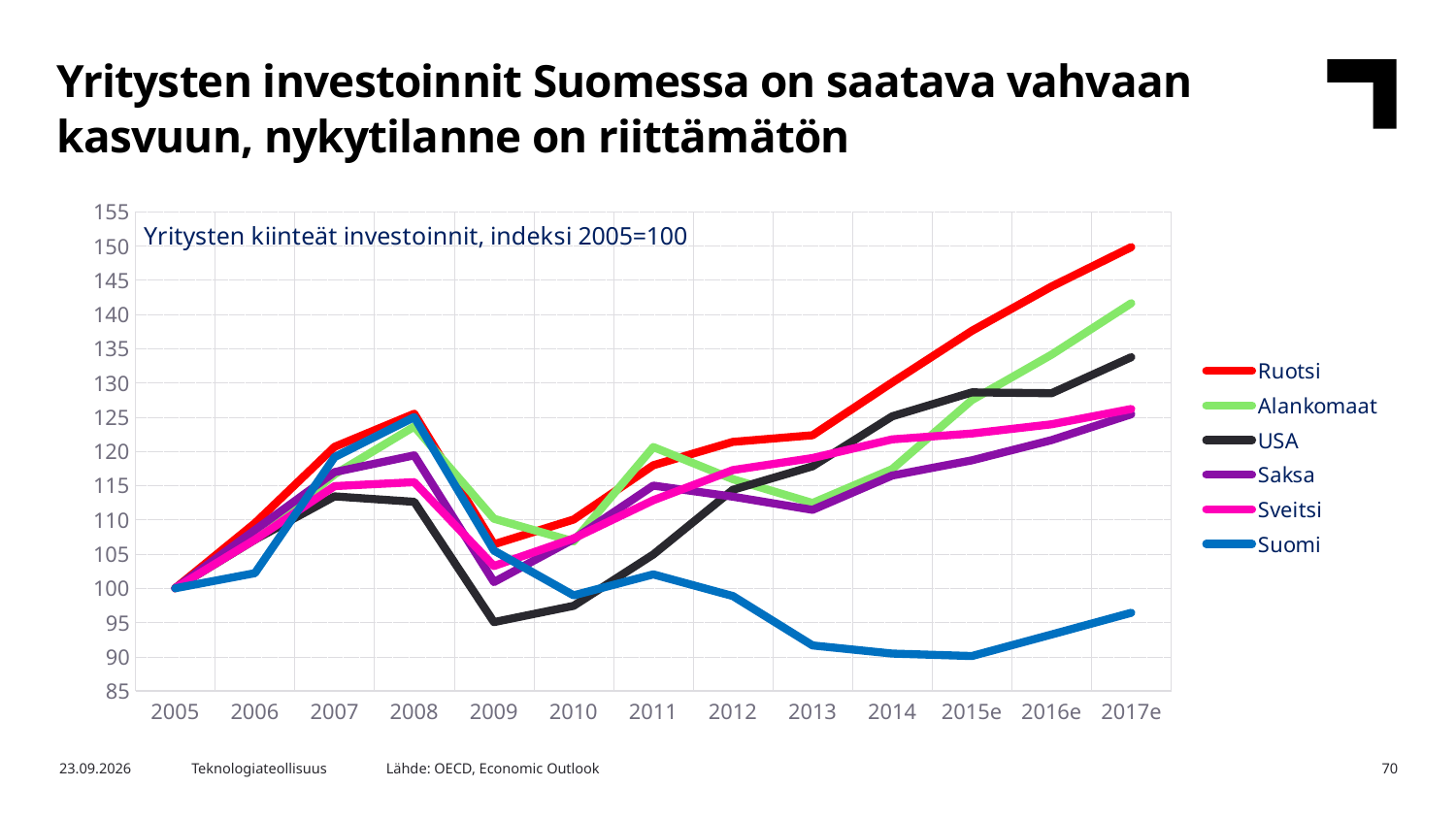
What is the subtitle printed inside the chart area? Yritysten kiinteät investoinnit, indeksi 2005=100 Does the Suomi line rise or fall from 2012 to 2015e? fall What kind of chart is shown on the slide? line chart Is the value for Suomi in 2015e greater or less than 95? less How many series does the legend list? 6 Which series has the lowest value in 2017e? Suomi Which series has the lowest value in 2009? USA How many years are shown along the x axis? 13 In 2017e, which is larger: Alankomaat or USA? Alankomaat Which series has the highest value in 2017e? Ruotsi What is the index value for Ruotsi in 2005? 100 Is the value for Ruotsi in 2017e greater or less than 145? greater